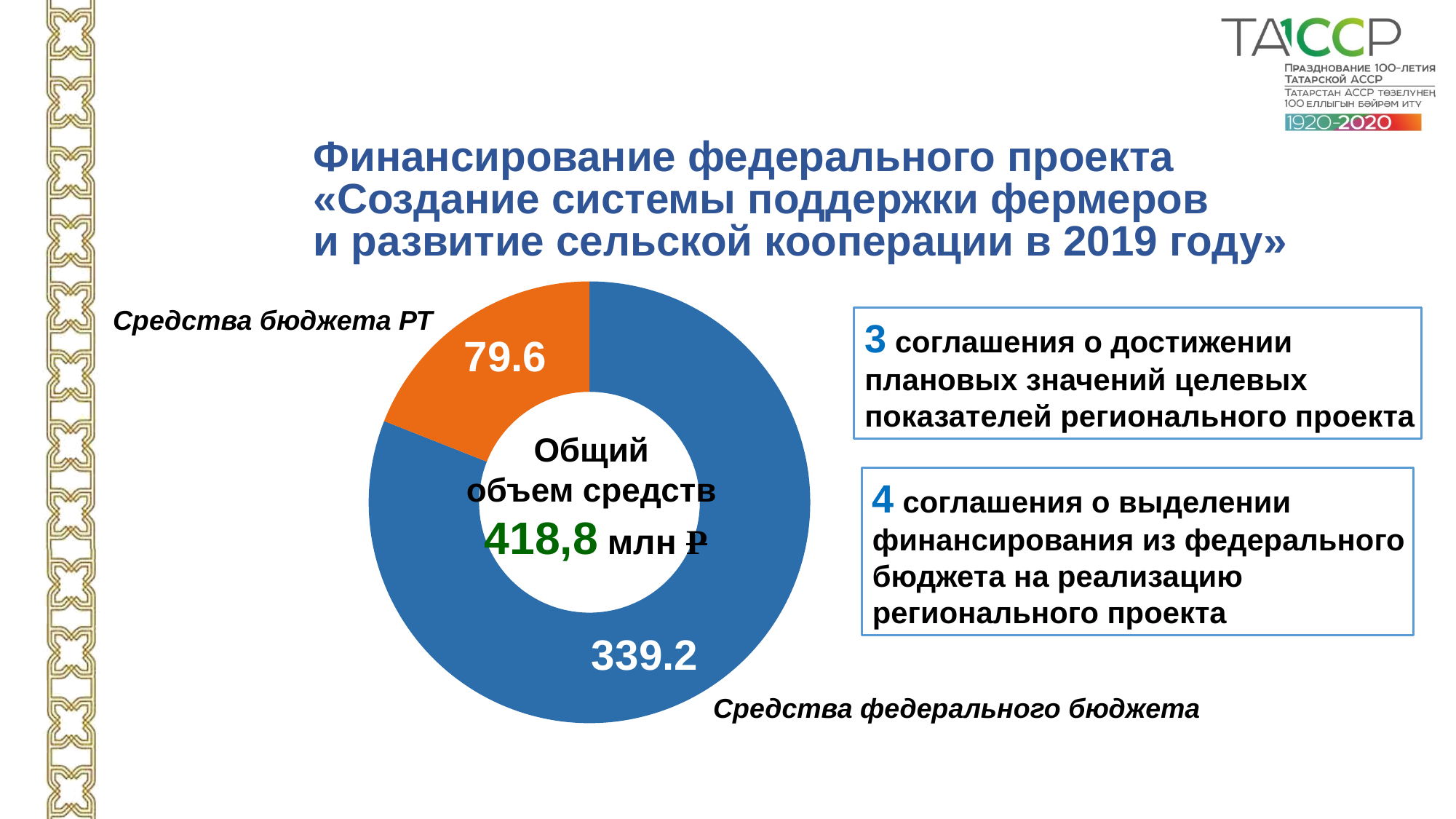
Which category has the largest slice in the chart? Средства федерального бюджета What is the value for Средства бюджета РТ in the doughnut chart? 79.6 What is the value for Средства федерального бюджета in the doughnut chart? 339.2 Which category has the smallest slice in the chart? Средства бюджета РТ How many categories (slices) does the chart show? 2 What kind of chart is shown on the slide? Doughnut (pie) chart What total amount is shown in the centre of the doughnut chart? 418,8 млн ₽ Which is larger: Средства бюджета РТ or Средства федерального бюджета? Средства федерального бюджета What colour is the slice for Средства федерального бюджета? Blue What is the difference between the value for Средства федерального бюджета and the value for Средства бюджета РТ? 259.6